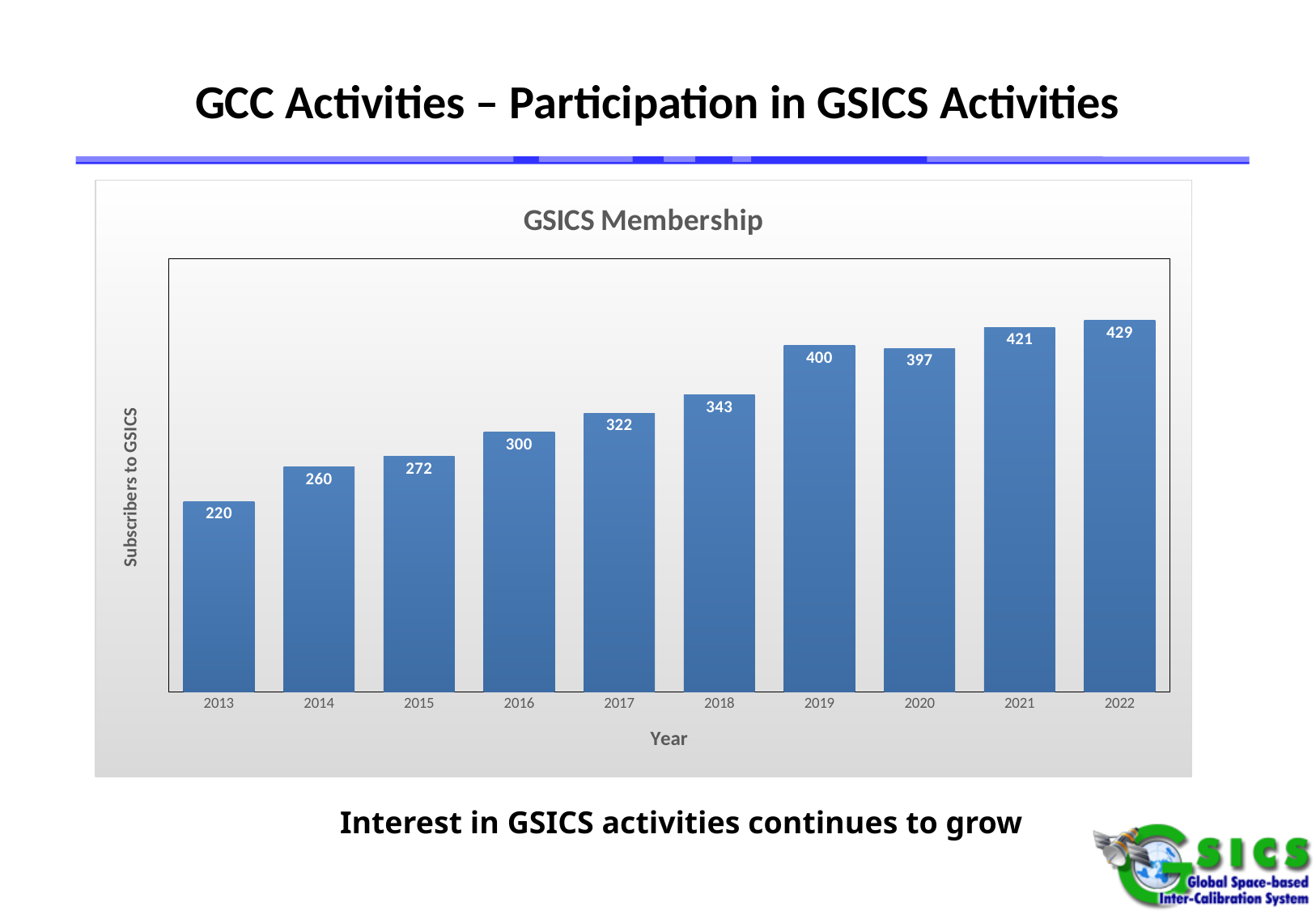
What is the number of subscribers to GSICS in 2022? 429 Which year has the lowest number of subscribers to GSICS? 2013 What is the difference in subscribers between 2019 and 2020? 3 How many years are shown on the x axis of the chart? 10 What is the difference in subscribers between 2022 and 2013? 209 Which year has more subscribers, 2016 or 2018? 2018 What kind of chart is shown on the slide? Bar chart What is the title of the chart? GSICS Membership Which year has the highest number of subscribers to GSICS? 2022 What is the number of subscribers to GSICS in 2019? 400 What is the number of subscribers to GSICS in 2013? 220 Do the subscriber numbers generally rise or fall from 2013 to 2022? Rise